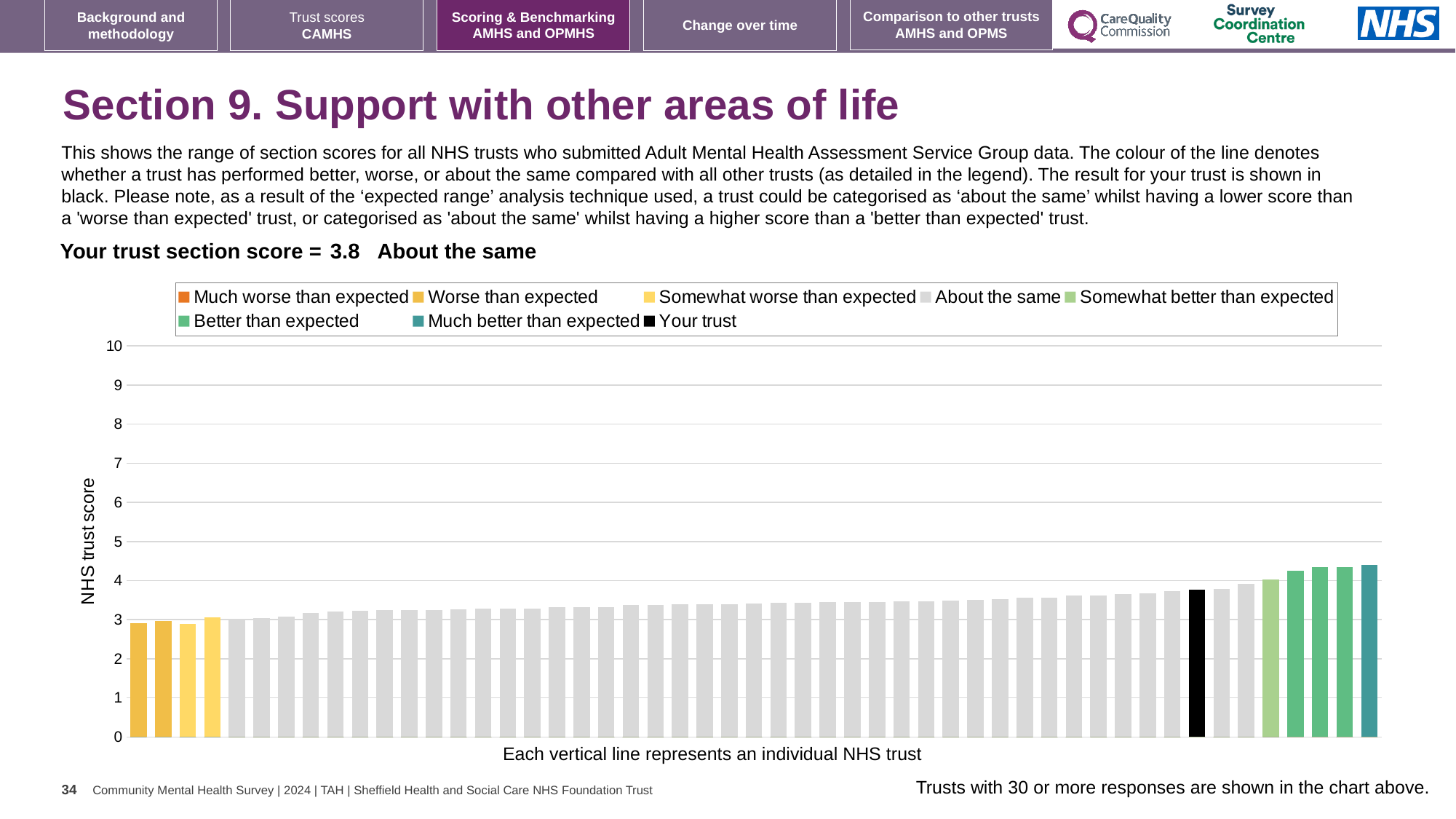
What is the section score for your trust shown on the slide? 3.8 Is the value of the black 'Your trust' bar greater or less than 4? less Is the value of the leftmost bar in the chart greater or less than 2? greater Do the bar values rise or fall from left to right along the x axis? rise How many bars are coloured as 'Much better than expected'? 1 Which category is your trust's section score placed in? About the same How many entries does the chart legend list? 8 Is the value of the tallest bar in the chart greater or less than 4? greater What kind of chart is shown on the slide? bar chart What is the label on the vertical axis of the chart? NHS trust score Which legend category does the tallest bar belong to? Much better than expected